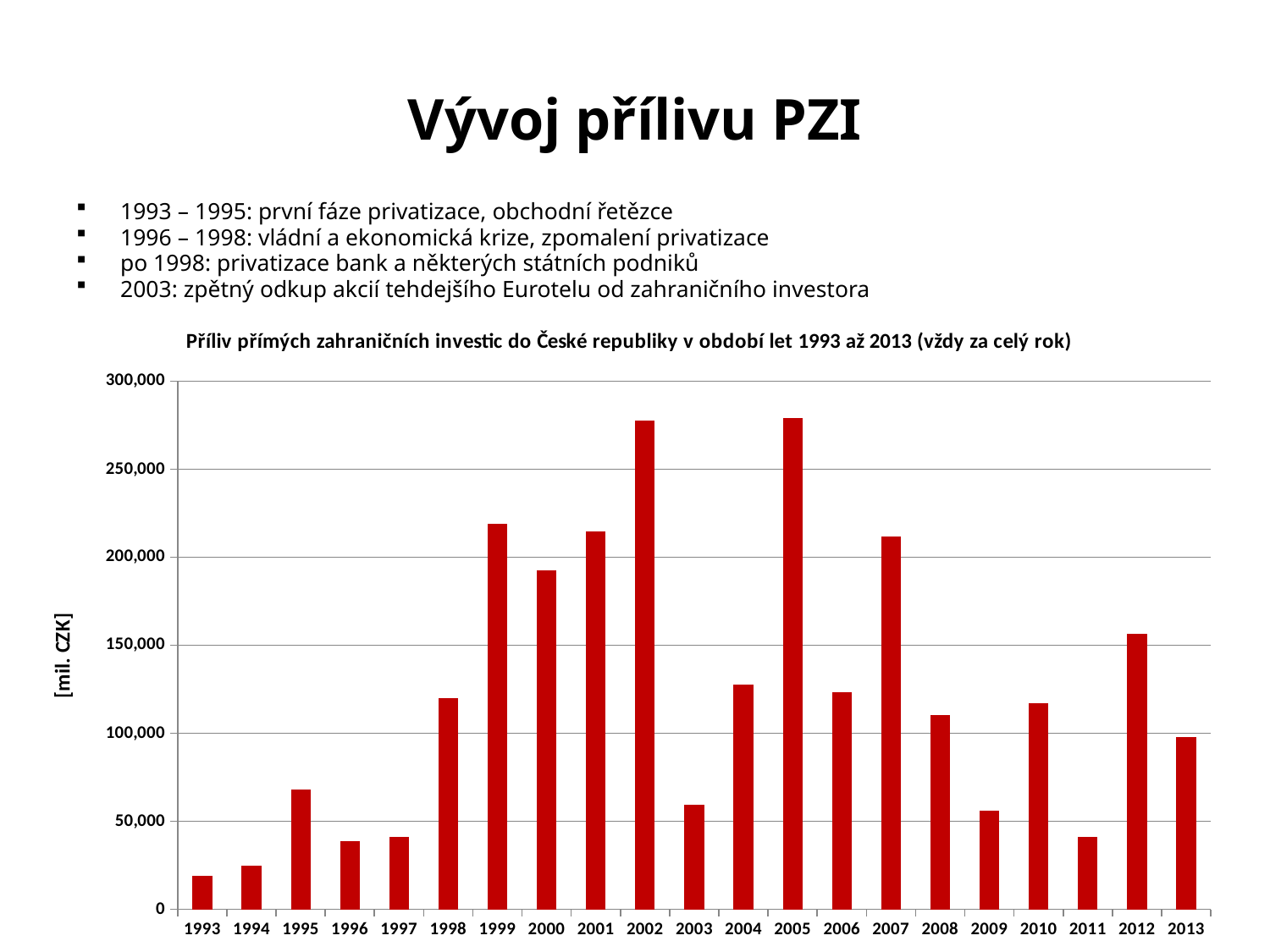
Do the values rise or fall from 1996 to 1999? rise What kind of chart is shown on the slide? bar chart How many years are plotted on the x axis of the chart? 21 Is the value for 1998 greater or less than 100,000? greater What unit is shown on the y axis label of the chart? [mil. CZK] Is the value for 2011 greater or less than 50,000? less Is the value for 2000 greater or less than 200,000? less Which year has the larger value, 1995 or 1997? 1995 Which year has the lowest inflow of foreign direct investment in the chart? 1993 Which year has the larger value, 2012 or 2013? 2012